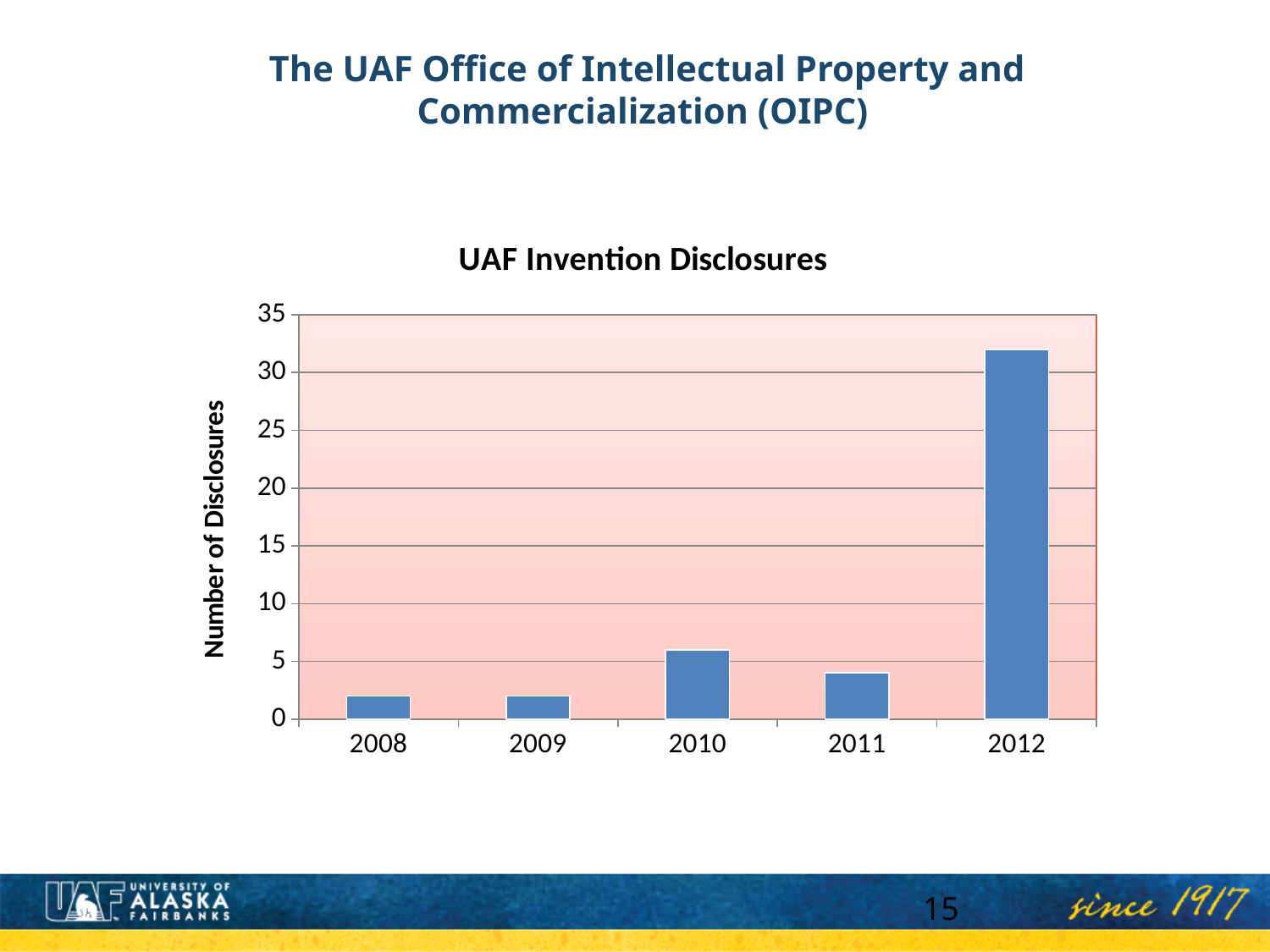
Which year has the larger value, 2009 or 2012? 2012 Is the value for 2011 greater or less than 5? less Which year has the highest number of disclosures? 2012 What type of chart is shown on the slide? bar chart Is the value for 2012 greater or less than 30? greater Which year has the larger value, 2010 or 2011? 2010 How many years are shown on the x axis of the chart? 5 Overall, do the values rise or fall from 2008 to 2012? rise What is the title of the chart? UAF Invention Disclosures Is the value for 2008 greater or less than 5? less What is the label on the vertical axis of the chart? Number of Disclosures